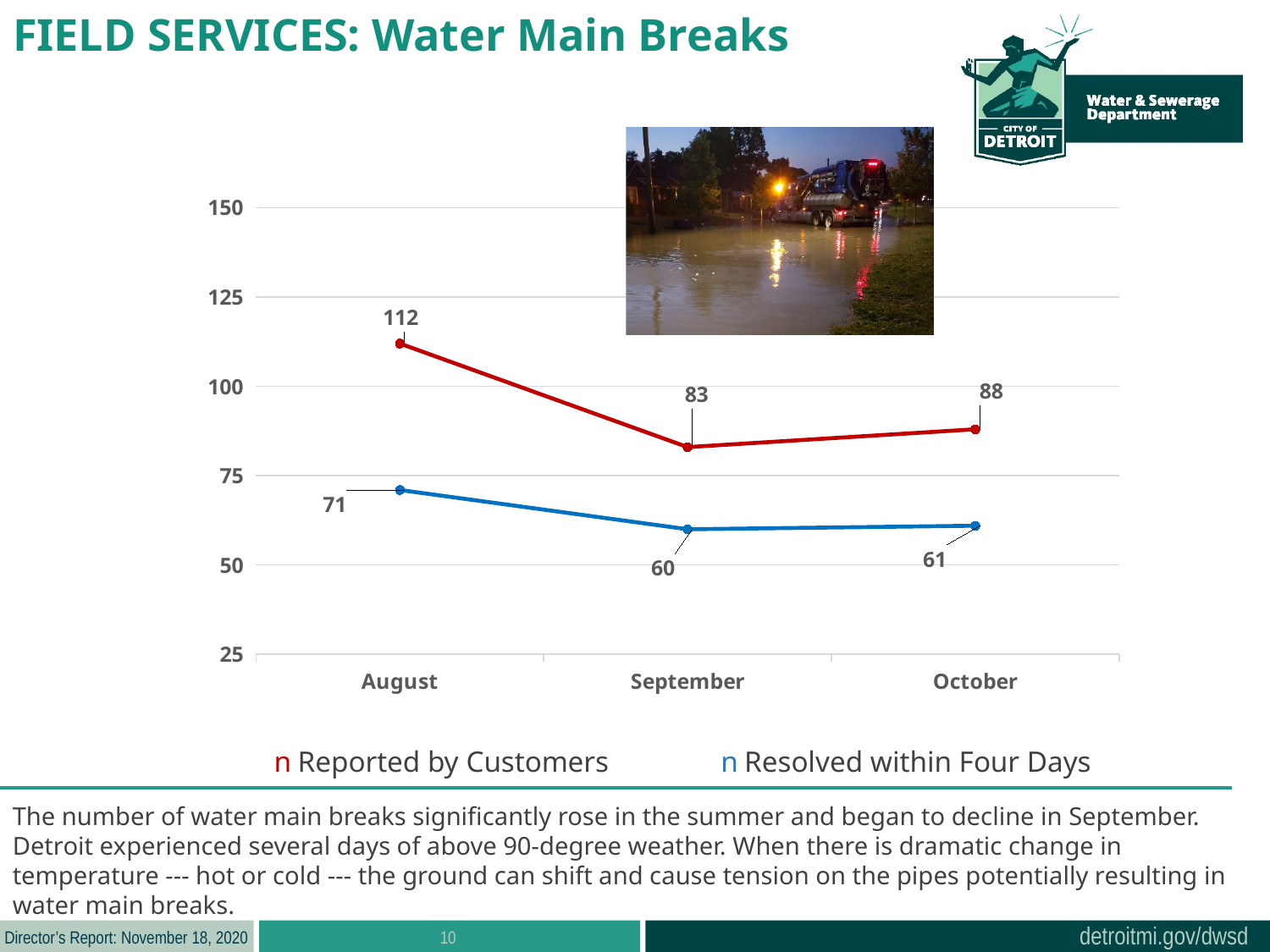
How many series does the legend list? 2 What is the value for Reported by Customers in August? 112 In which month is the Resolved within Four Days value lowest? September Which is larger in September: Reported by Customers or Resolved within Four Days? Reported by Customers In which month is the Reported by Customers value highest? August What kind of chart is shown on the slide? Line chart What is the value for Resolved within Four Days in September? 60 How many months are shown on the x axis? 3 What is the difference between Reported by Customers and Resolved within Four Days in August? 41 Does the Reported by Customers series rise or fall from August to September? Fall What is the value for Reported by Customers in October? 88 What is the value for Resolved within Four Days in October? 61